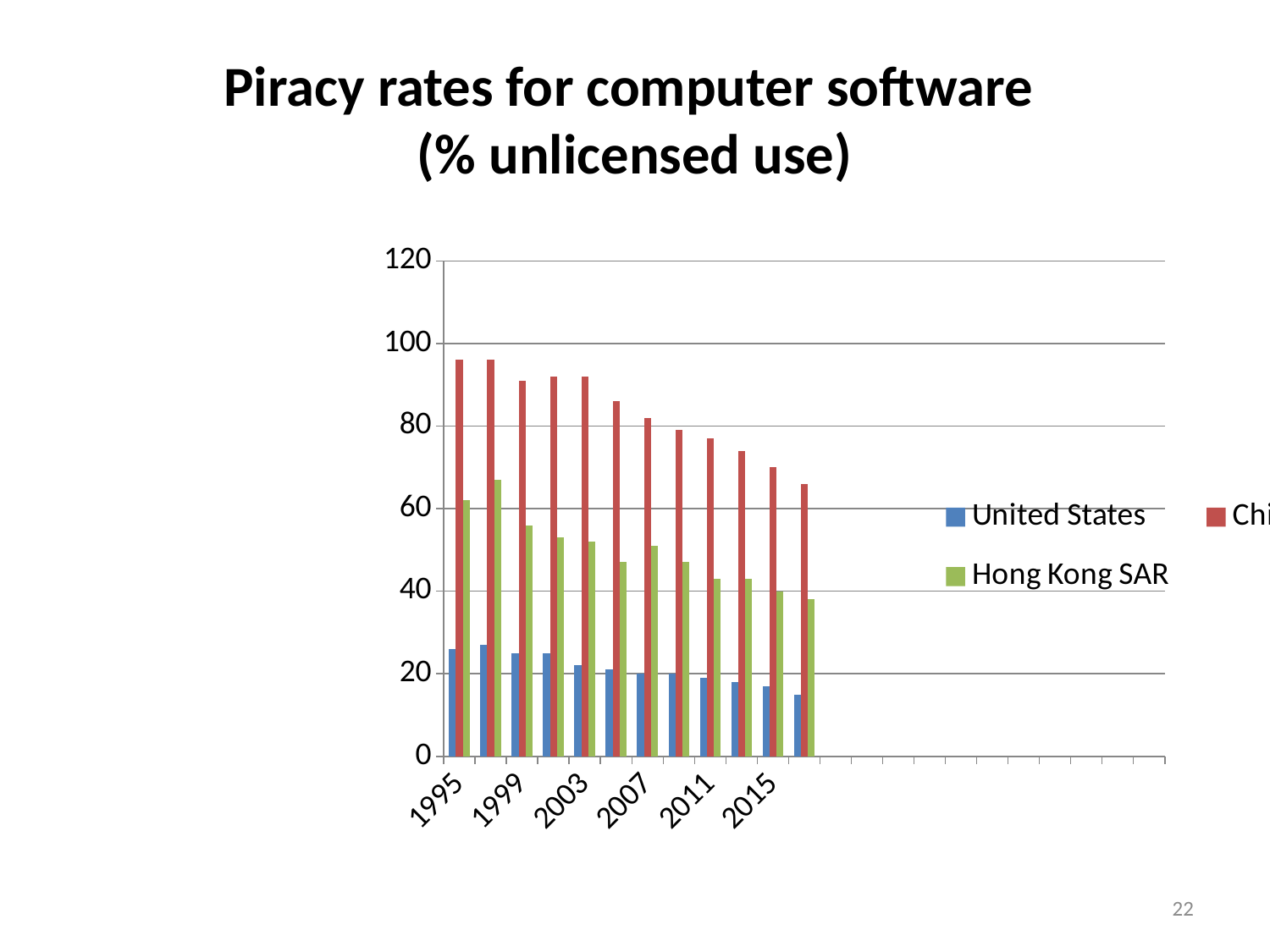
Is the value for United States in 2015 greater or less than 20? less Is the value for the red series in 1995 greater or less than 80? greater Is the value for United States in 1995 greater or less than 40? less In 2003, which is larger: the value for Hong Kong SAR or the value for United States? Hong Kong SAR What colour are the bars for Hong Kong SAR? green How many series does the legend list? 3 What kind of chart is shown on the slide? bar chart Do the values for United States rise or fall from 1995 to 2015? fall What is the title of the chart? Piracy rates for computer software (% unlicensed use)